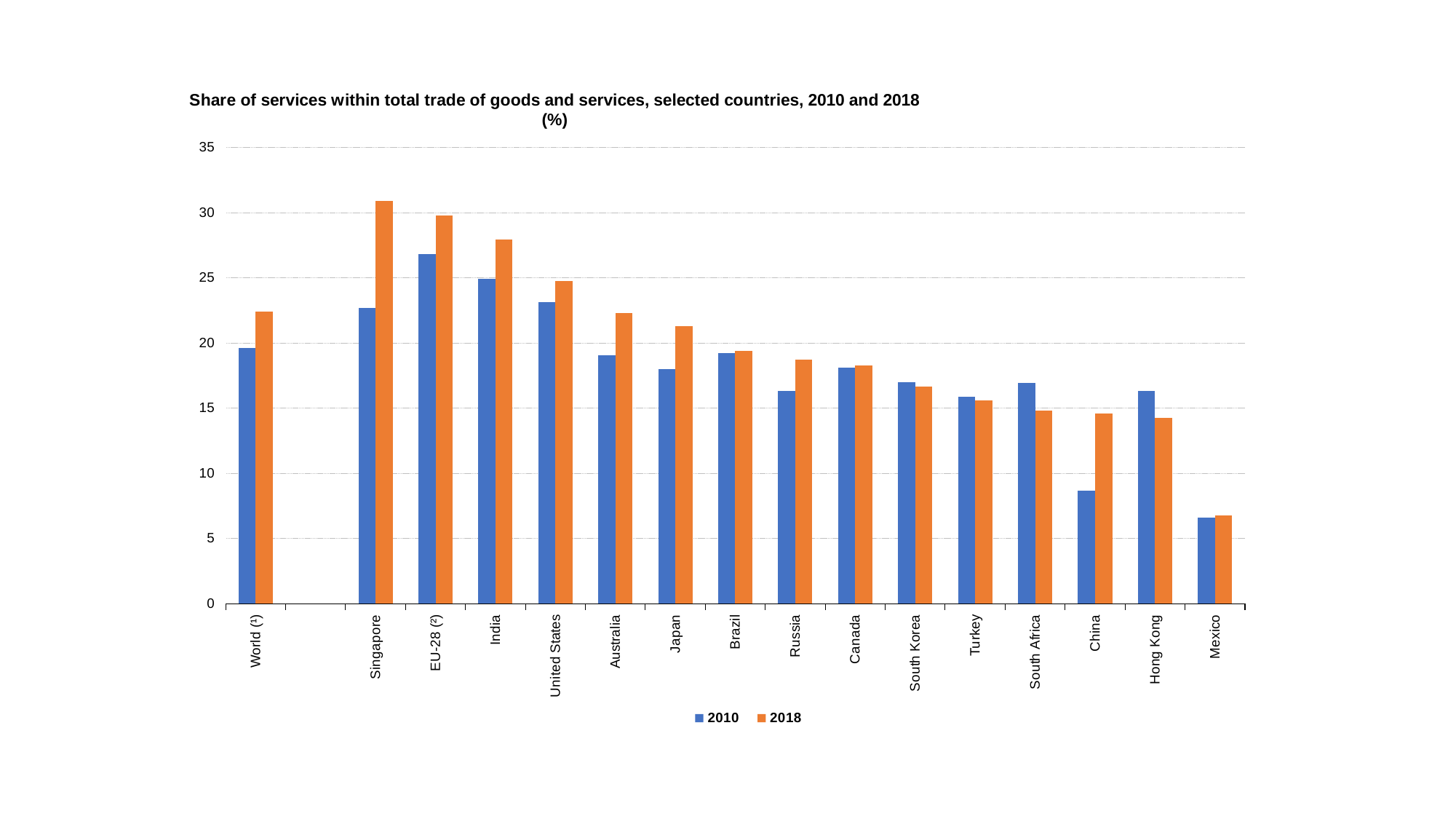
For Hong Kong, which is larger: the 2010 value or the 2018 value? 2010 Which country has the lowest value for 2018? Mexico Which country has the highest value for 2018? Singapore How many countries or regions are shown on the x axis? 16 How many series does the legend list? 2 Is the 2018 value for Singapore greater or less than 30? greater Is the 2010 value for China greater or less than 10? less What kind of chart is shown on the slide? bar chart Is the 2018 value for Hong Kong greater or less than 15? less What colour are the bars for the 2018 series? orange For China, which is larger: the 2010 value or the 2018 value? 2018 Which category has the highest value for 2010? EU-28 (²)